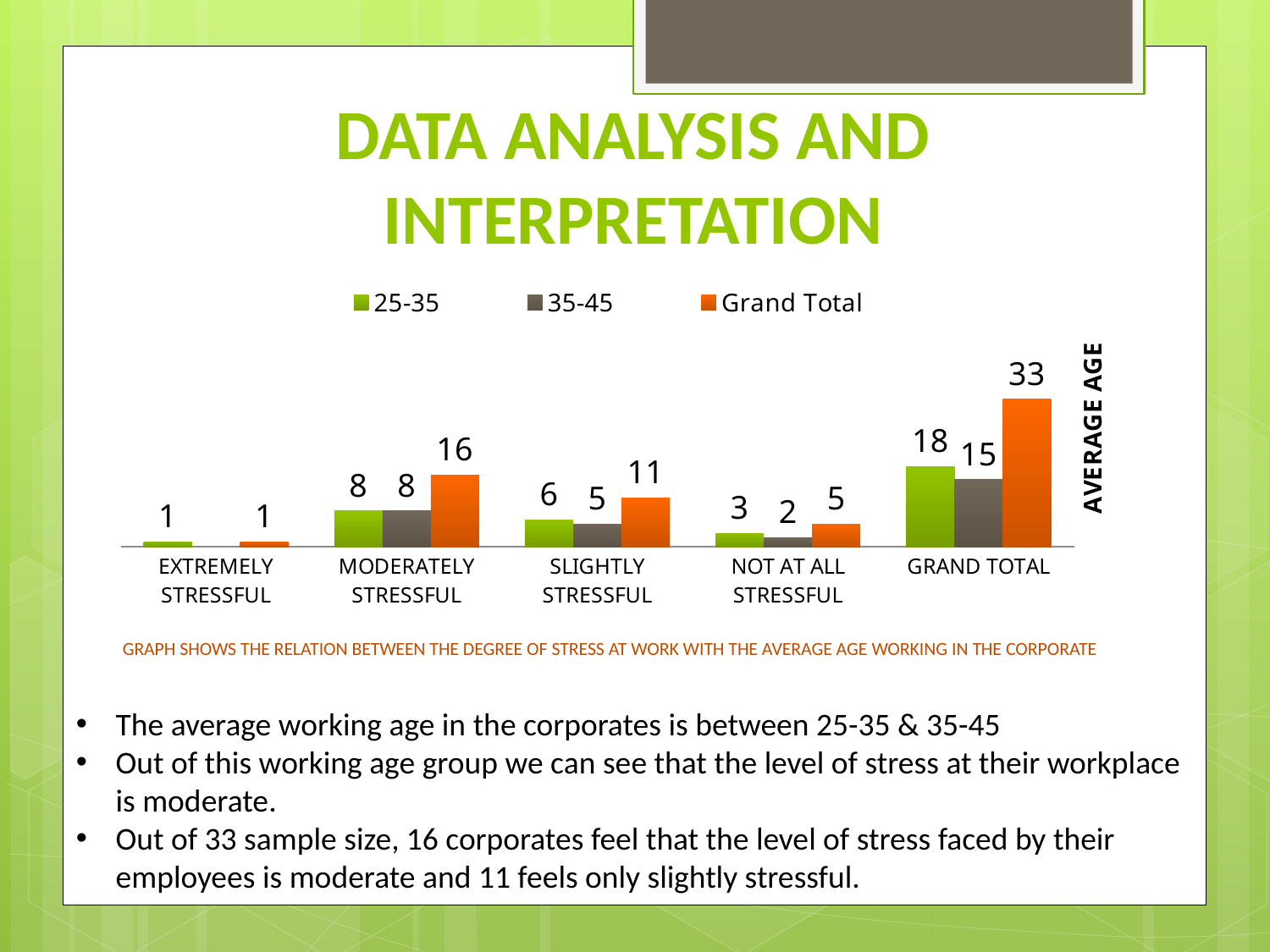
What is the Grand Total value for Moderately Stressful? 16 What is the label of the vertical axis title on the right side of the chart? AVERAGE AGE What kind of chart is shown on the slide? Bar chart What is the value for the 25-35 series in the Slightly Stressful category? 6 What is the value for the 25-35 series in the Grand Total category? 18 What is the value for the 35-45 series in the Not At All Stressful category? 2 How many categories are shown on the x axis? 5 Excluding the Grand Total category, which stress level has the lowest value for the 25-35 series? Extremely Stressful How many series does the legend list? 3 What is the difference between the Grand Total values for Moderately Stressful and Slightly Stressful? 5 Excluding the Grand Total category, which stress level has the highest Grand Total value? Moderately Stressful Which is larger: the 25-35 value for Slightly Stressful or the 35-45 value for Slightly Stressful? 25-35